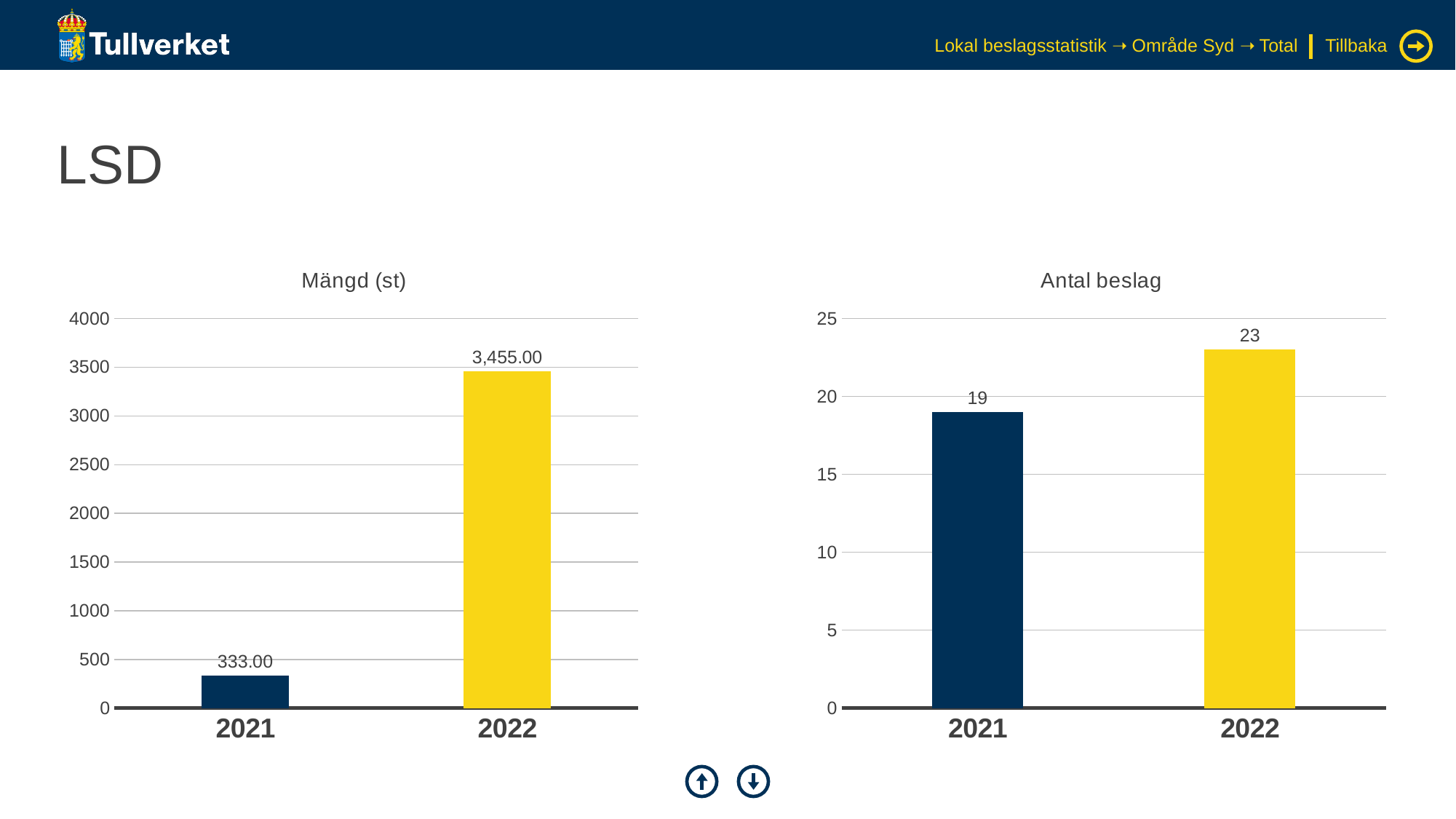
In the 'Mängd (st)' chart, what is the value for 2022? 3,455.00 In the 'Antal beslag' chart, what is the value for 2022? 23 In the 'Mängd (st)' chart, which year has the highest value? 2022 In the 'Mängd (st)' chart, do the values rise or fall from 2021 to 2022? rise In the 'Antal beslag' chart, is the value for 2021 greater or less than 20? less In the 'Antal beslag' chart, what is the difference between the 2022 and 2021 values? 4 How many categories are shown on the x axis of the 'Mängd (st)' chart? 2 In the 'Mängd (st)' chart, what is the difference between the 2022 and 2021 values? 3,122.00 What kind of chart is the 'Antal beslag' chart? bar chart In the 'Antal beslag' chart, which year has the lowest value? 2021 In the 'Antal beslag' chart, what is the value for 2021? 19 In the 'Mängd (st)' chart, what is the value for 2021? 333.00